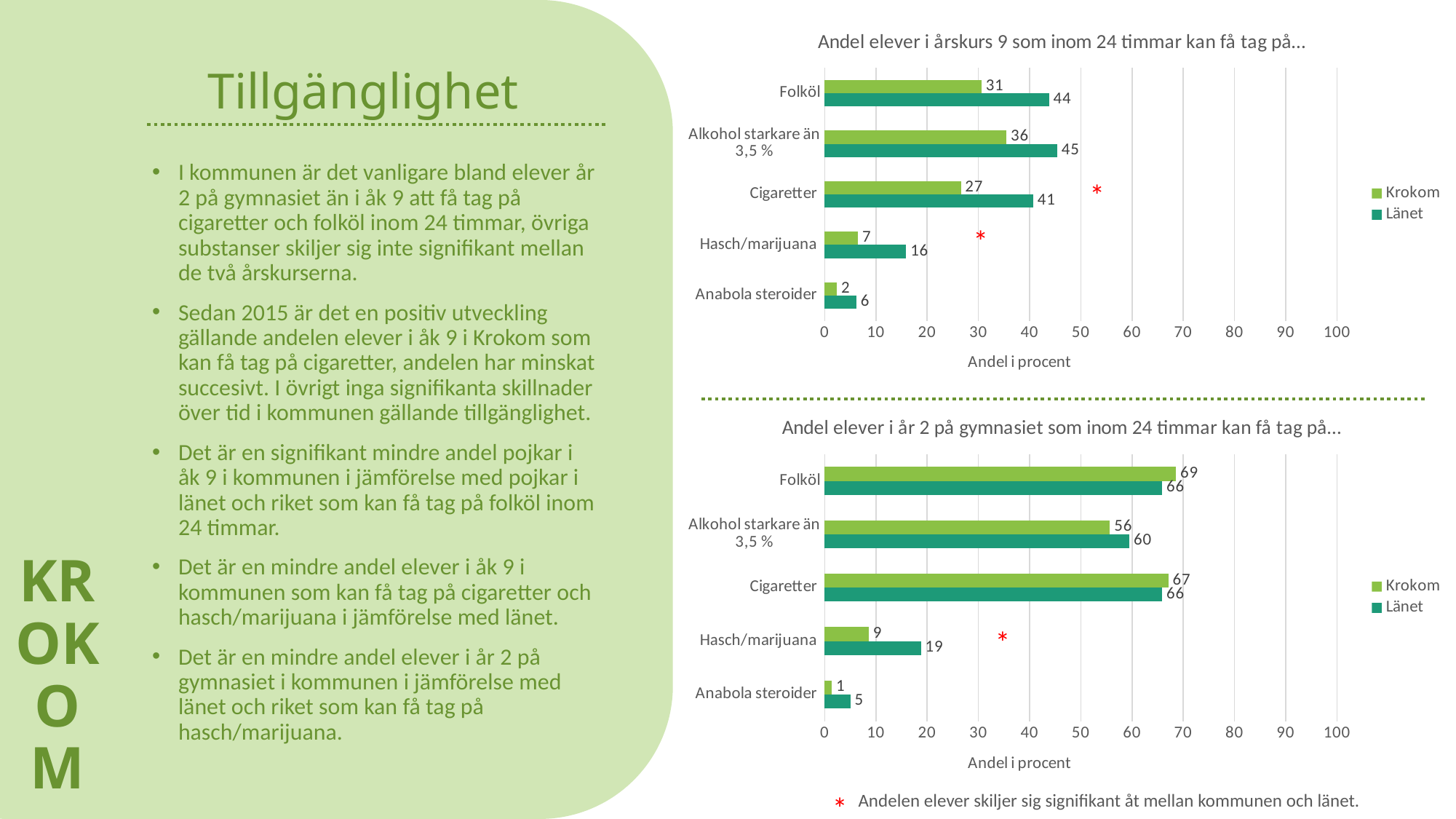
In the bottom chart (år 2 på gymnasiet), what is the value for Krokom for Cigaretter? 67 How many series does the legend of the bottom chart list? 2 In the top chart (årskurs 9), what is the difference between Länet and Krokom for Hasch/marijuana? 9 In the top chart (årskurs 9), what is the value for Länet for Cigaretter? 41 In the top chart (årskurs 9), which category has the lowest value for Krokom? Anabola steroider In the bottom chart (år 2 på gymnasiet), what is the difference between Krokom and Länet for Folköl? 3 In the bottom chart (år 2 på gymnasiet), which is larger for Alkohol starkare än 3,5 %: Krokom or Länet? Länet In the top chart (årskurs 9), what is the value for Krokom for Folköl? 31 In the bottom chart (år 2 på gymnasiet), what is the value for Länet for Hasch/marijuana? 19 What type of chart is the top chart? Bar chart In the top chart (årskurs 9), which category has the highest value for Länet? Alkohol starkare än 3,5 % In the top chart (årskurs 9), how many categories are shown? 5